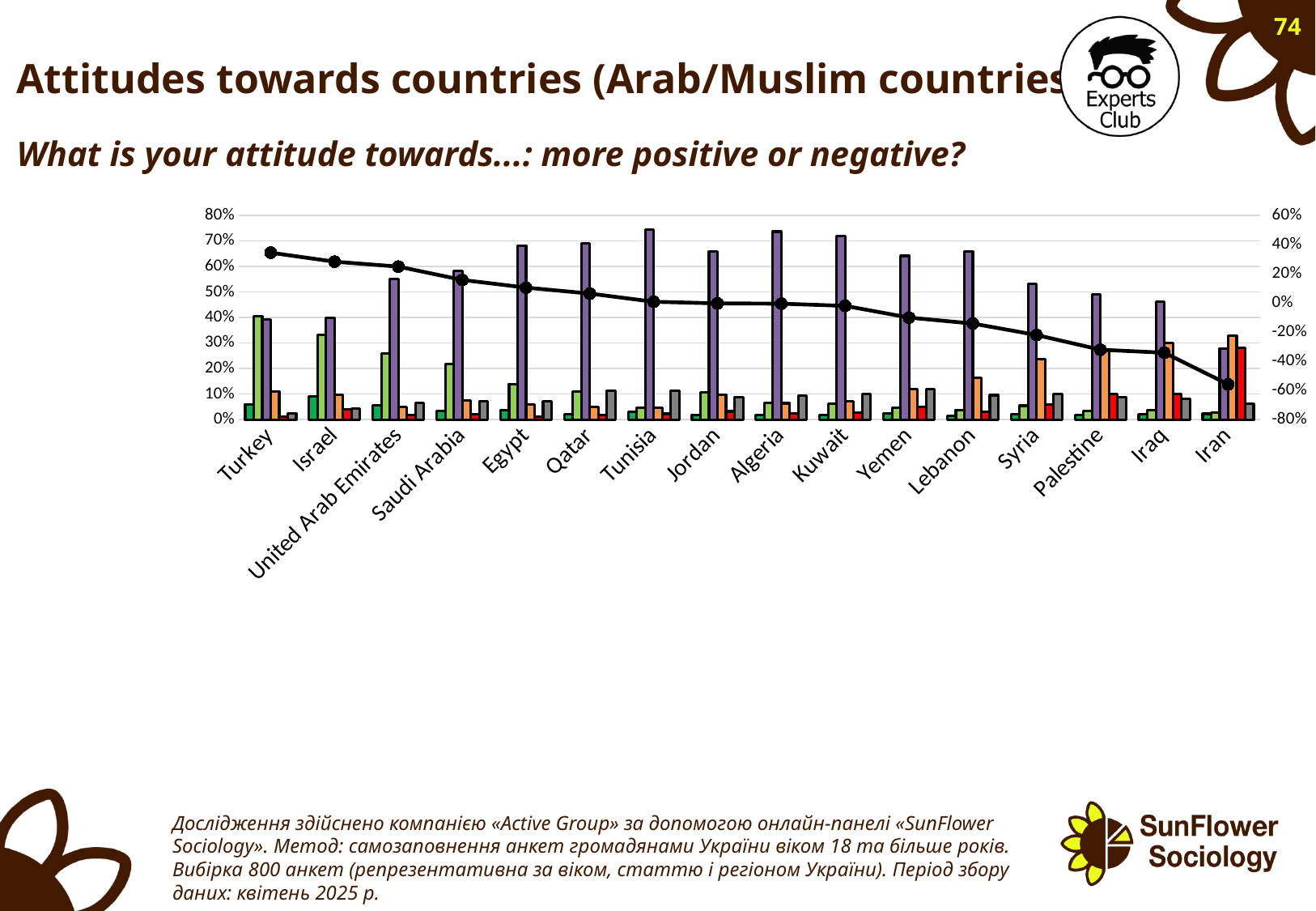
Is the orange bar for Palestine greater or less than 20% on the left axis? greater Is the purple bar for Tunisia greater or less than 70% on the left axis? greater Is the purple bar for Iran greater or less than 40% on the left axis? less Which country has the highest light green bar? Turkey How many countries are shown on the x axis of the chart? 16 Does the black line rise or fall from Turkey to Iran along the x axis? falls Which country is listed first on the x axis of the chart? Turkey What kind of chart is shown on the slide? bar chart with a line Which country has the lowest purple bar? Iran Which is larger, the purple bar for Israel or the purple bar for Egypt? Egypt Which country is listed last on the x axis of the chart? Iran